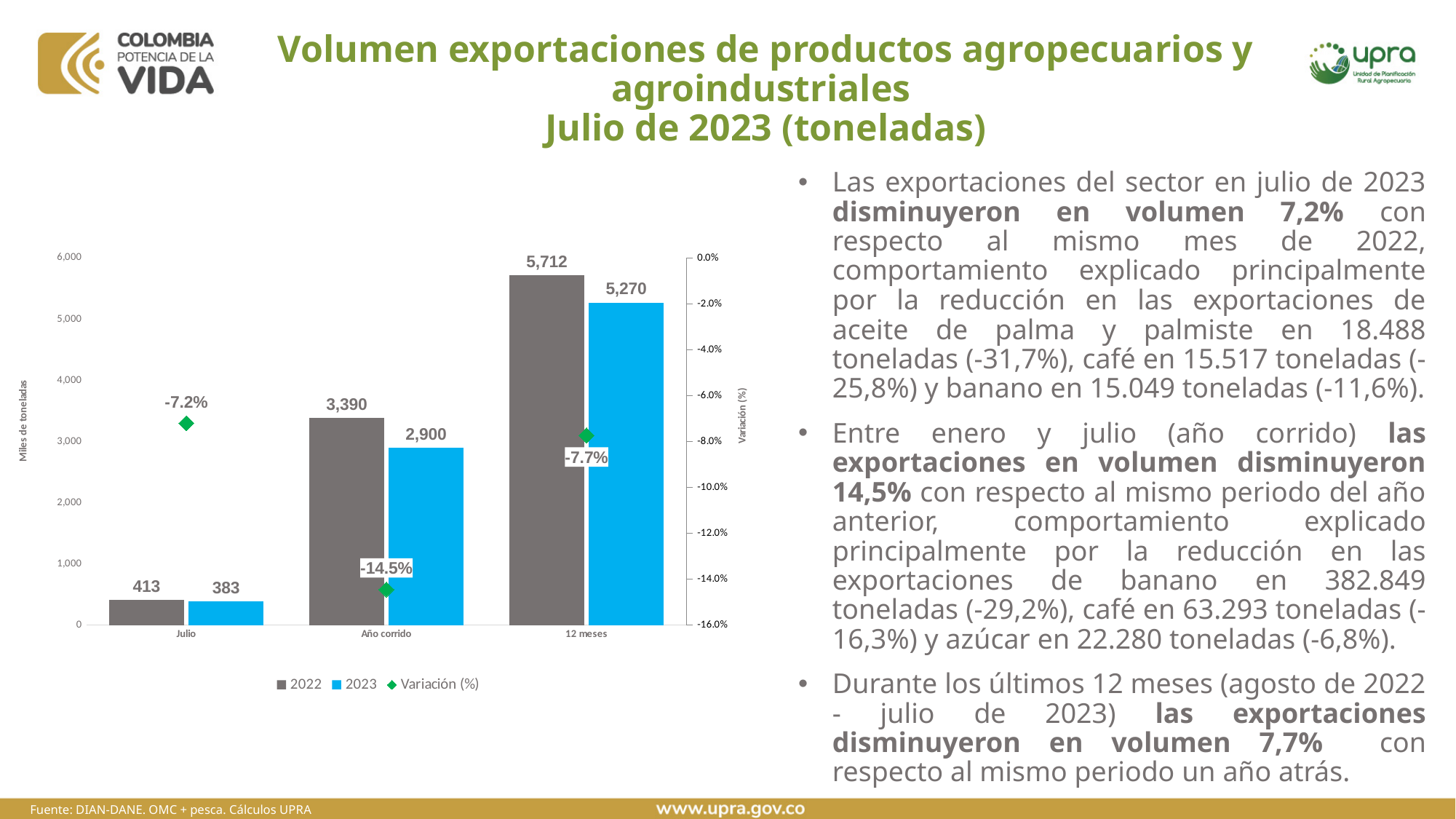
What is the 2022 value for Julio? 413 What is the difference between the 2022 and 2023 values for Año corrido? 490 What is the 2022 value for 12 meses? 5,712 Which is larger, the 2022 value for 12 meses or the 2023 value for 12 meses? 2022 value for 12 meses How many series does the legend list? 3 Which category has the lowest 2022 value? Julio Which category has the highest 2023 value? 12 meses What kind of chart is shown on the slide? Bar chart with a line/marker series How many categories are shown on the x axis? 3 Which category has the lowest Variación (%) value? Año corrido What is the Variación (%) value for 12 meses? -7.7% What is the 2023 value for Año corrido? 2,900